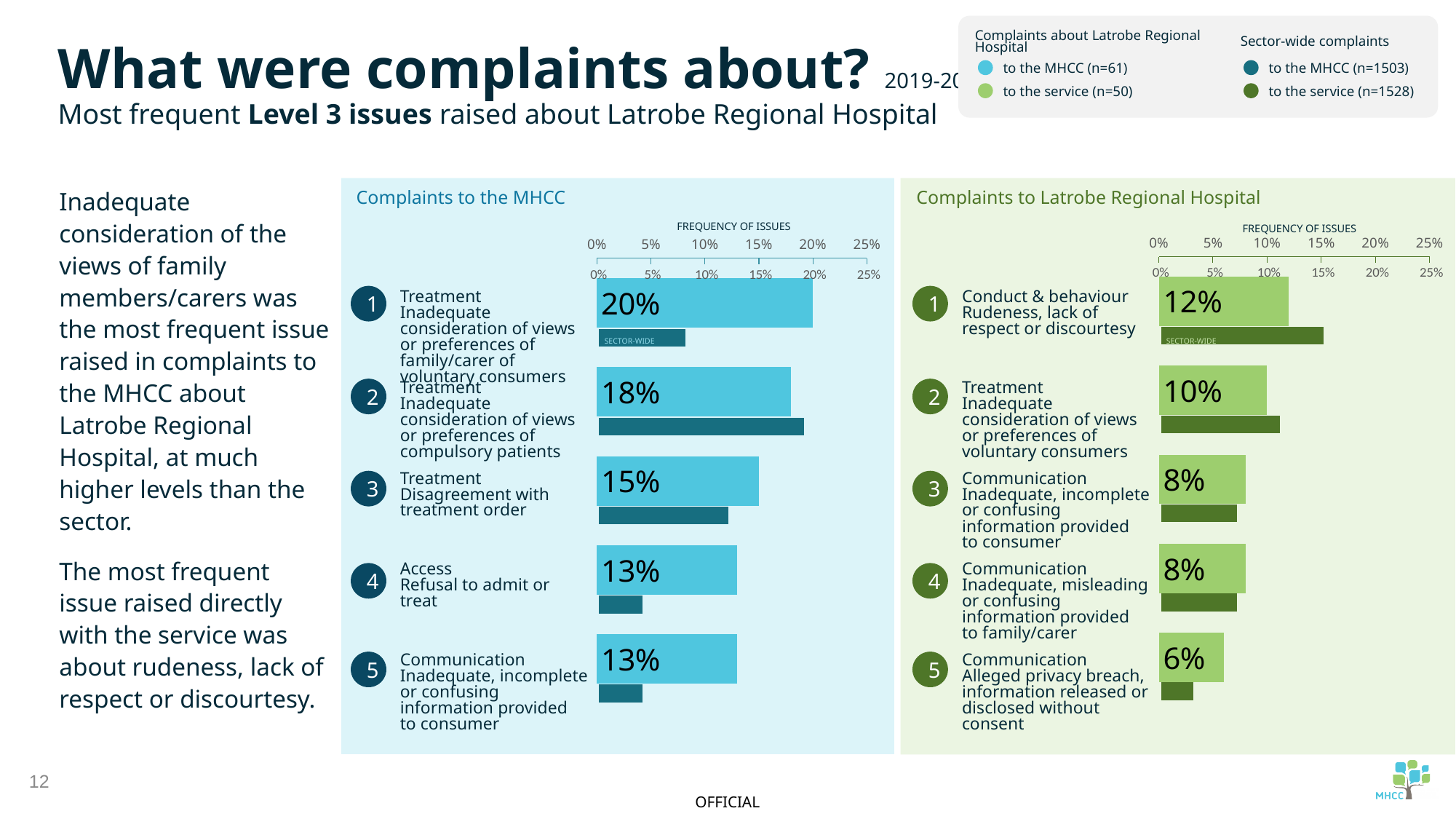
In the 'Complaints to the MHCC' chart, what is the frequency of 'Treatment – Disagreement with treatment order'? 15% In the 'Complaints to Latrobe Regional Hospital' chart, which issue has the lowest frequency? Communication – Alleged privacy breach, information released or disclosed without consent In the 'Complaints to Latrobe Regional Hospital' chart, what is the frequency of 'Conduct & behaviour – Rudeness, lack of respect or discourtesy'? 12% What type of chart is used in the 'Complaints to Latrobe Regional Hospital' panel? Bar chart In the 'Complaints to the MHCC' chart, is the sector-wide bar for issue 1 (family/carer of voluntary consumers) greater or less than 10%? less In the 'Complaints to Latrobe Regional Hospital' chart, what is the difference between the frequency of 'Conduct & behaviour' (12%) and 'Treatment – Inadequate consideration of views or preferences of voluntary consumers' (10%)? 2% In the 'Complaints to the MHCC' chart, which issue has the highest frequency? Treatment – Inadequate consideration of views or preferences of family/carer of voluntary consumers In the 'Complaints to Latrobe Regional Hospital' chart, is the sector-wide bar for 'Conduct & behaviour – Rudeness, lack of respect or discourtesy' greater or less than 12%? greater In the 'Complaints to the MHCC' chart, what is the frequency of the issue 'Treatment – Inadequate consideration of views or preferences of family/carer of voluntary consumers'? 20% In the 'Complaints to Latrobe Regional Hospital' chart, what is the frequency of 'Communication – Alleged privacy breach, information released or disclosed without consent'? 6% In the 'Complaints to the MHCC' chart, what is the difference between the frequency of issue 1 (20%) and issue 2 (18%)? 2% How many issues are listed in the 'Complaints to the MHCC' chart? 5